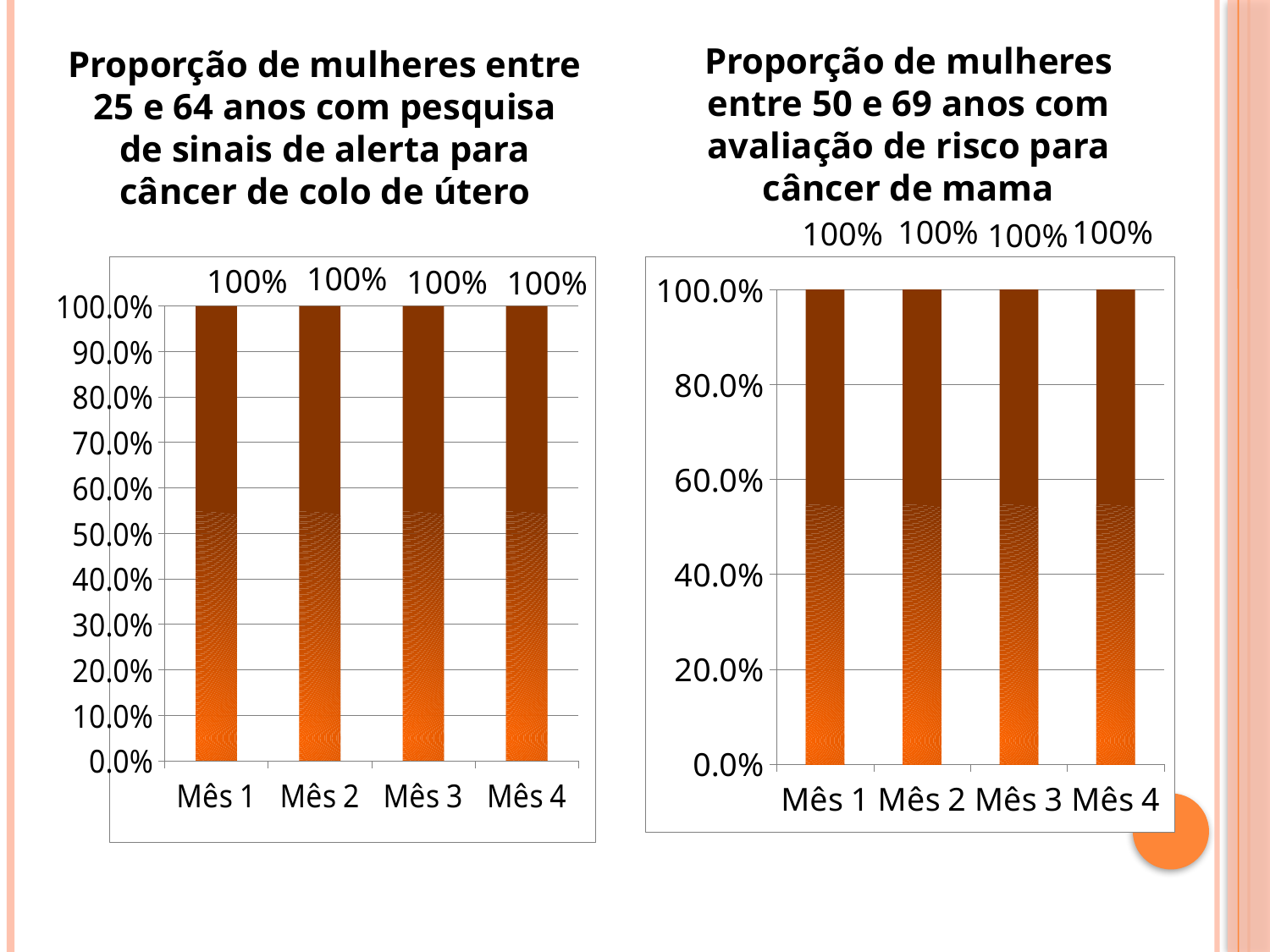
What is the title of the right chart? Proporção de mulheres entre 50 e 69 anos com avaliação de risco para câncer de mama In the left chart (câncer de colo de útero), what is the difference between the values for Mês 1 and Mês 3? 0% In the right chart (câncer de mama), what is the value for Mês 2? 100% What kind of chart is the right chart (câncer de mama)? Bar chart In the right chart (câncer de mama), what is the value for Mês 3? 100% In the right chart (câncer de mama), do the values rise, fall or stay the same from Mês 1 to Mês 4? Stay the same What is the label of the first category on the x axis of the left chart (câncer de colo de útero)? Mês 1 How many bars are plotted in the right chart (câncer de mama)? 4 In the left chart (câncer de colo de útero), what is the value for Mês 1? 100% What kind of chart is the left chart (câncer de colo de útero)? Bar chart In the left chart (câncer de colo de útero), what is the value for Mês 4? 100% How many categories are shown on the x axis of the left chart (câncer de colo de útero)? 4